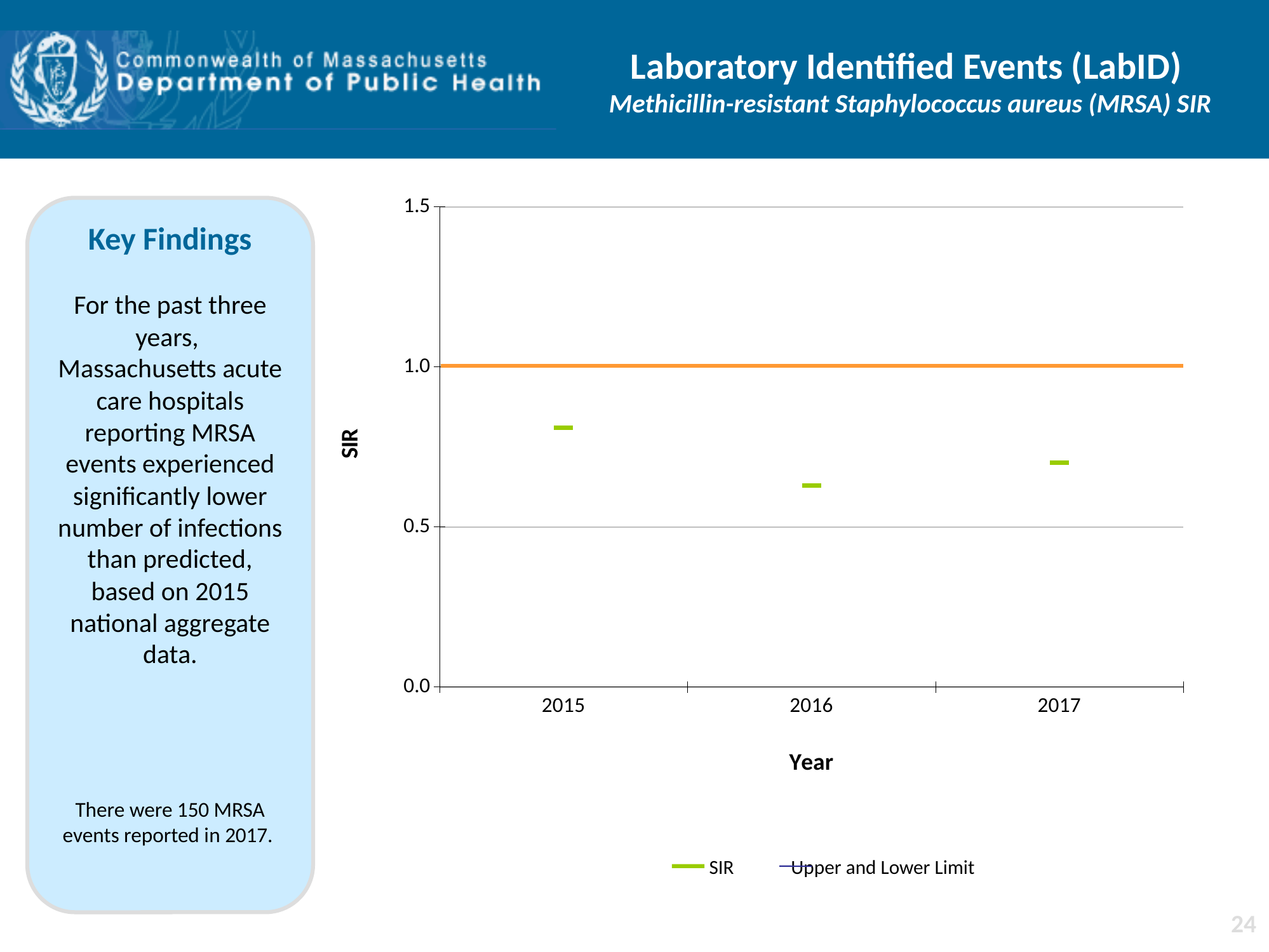
Which year has the lowest SIR value in the chart? 2016 Which year has the larger SIR value, 2015 or 2016? 2015 Is the SIR value for 2016 greater or less than 0.5? greater What kind of chart is shown on the slide? line chart Is the SIR value for 2017 greater or less than 1.0? less Is the SIR value for 2015 greater or less than 1.0? less Which year has the highest SIR value in the chart? 2015 How many series does the chart legend list? 2 How many years are plotted on the x axis of the chart? 3 Which year has the larger SIR value, 2016 or 2017? 2017 What is the label on the x axis of the chart? Year What are the two entries listed in the chart legend? SIR; Upper and Lower Limit